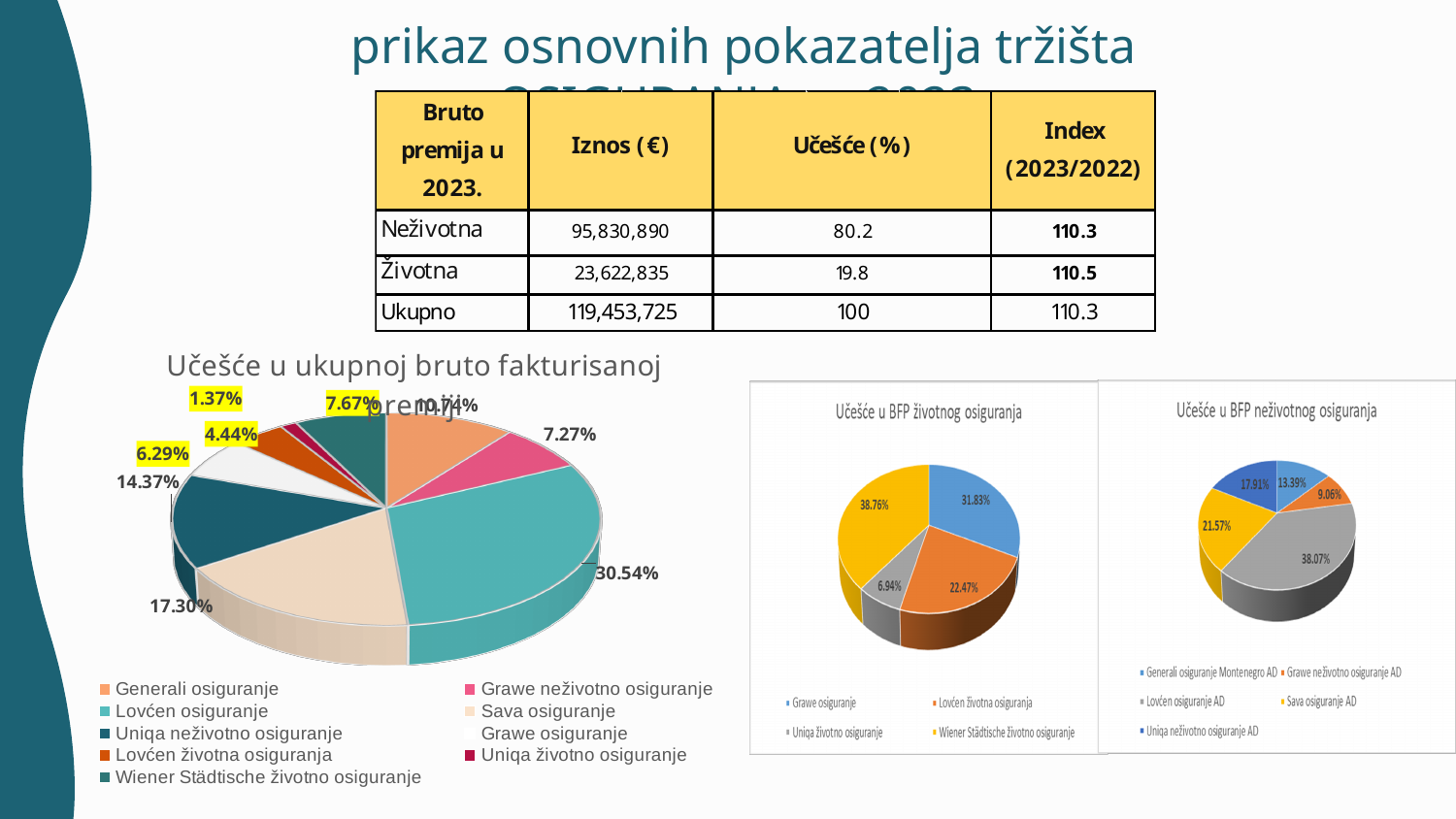
In the pie chart 'Učešće u ukupnoj bruto fakturisanoj premiji' on the left, what is the smallest slice's value? 1.37% What kind of chart is 'Učešće u BFP životnog osiguranja'? Pie chart In the pie chart 'Učešće u BFP neživotnog osiguranja', which is larger: the 21.57% slice or the 17.91% slice? 21.57% In the pie chart 'Učešće u ukupnoj bruto fakturisanoj premiji' on the left, what share is shown for Sava osiguranje? 17.30% In the pie chart 'Učešće u BFP životnog osiguranja', what is the share of Uniqa životno osiguranje? 6.94% In the pie chart 'Učešće u BFP neživotnog osiguranja', how many slices are there? 5 In the pie chart 'Učešće u BFP neživotnog osiguranja', what is the largest slice's value? 38.07% In the pie chart 'Učešće u ukupnoj bruto fakturisanoj premiji' on the left, what share is shown for Lovćen osiguranje? 30.54% In the pie chart 'Učešće u ukupnoj bruto fakturisanoj premiji' on the left, what is the largest slice's value? 30.54% In the pie chart 'Učešće u BFP životnog osiguranja', which company has the largest share? Wiener Städtische životno osiguranje In the pie chart 'Učešće u ukupnoj bruto fakturisanoj premiji' on the left, how many entries does the legend list? 9 In the pie chart 'Učešće u BFP životnog osiguranja', what is the difference between the shares of Grawe osiguranje (31.83%) and Lovćen životna osiguranja (22.47%)? 9.36%